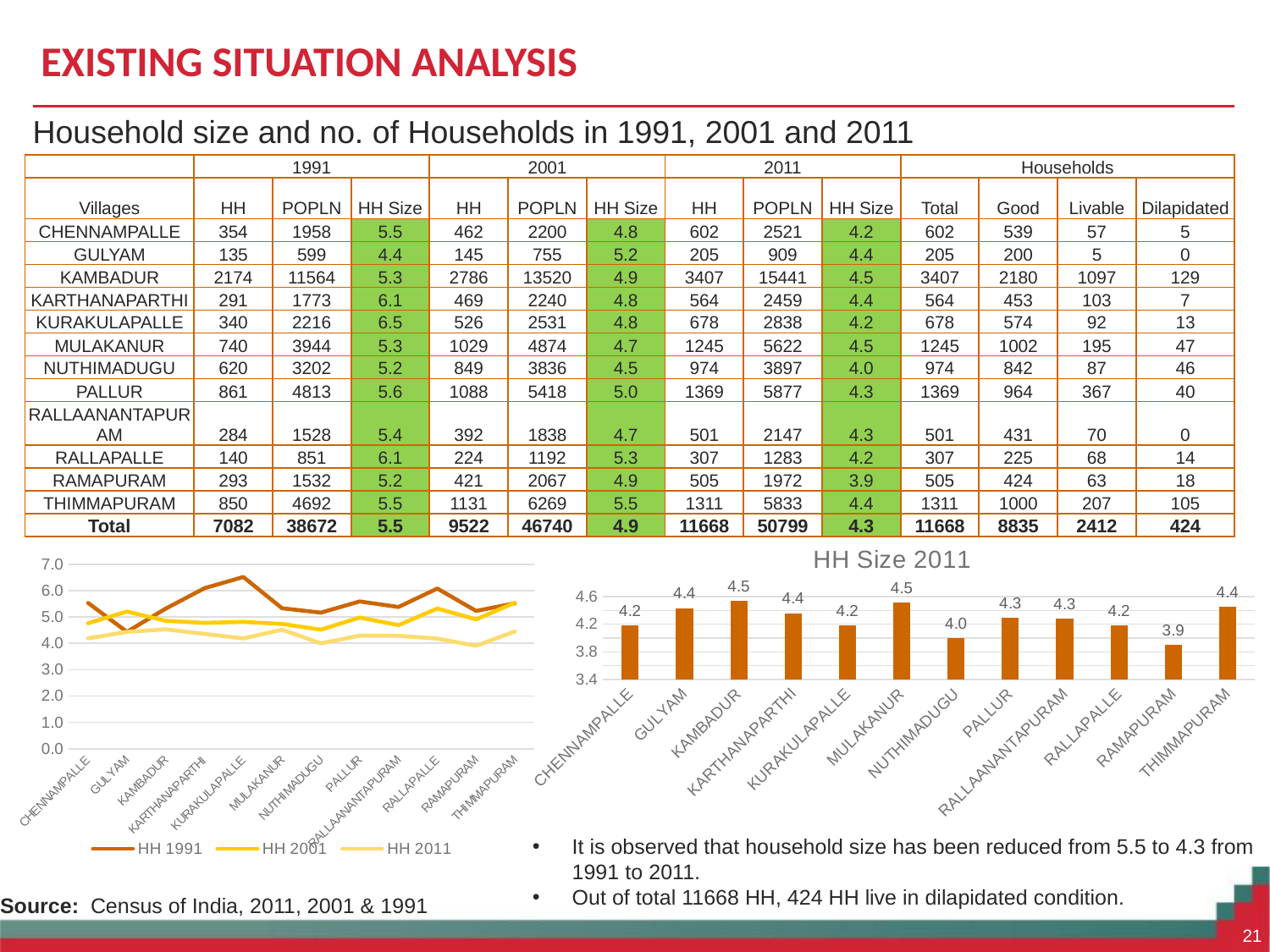
In the line chart on the bottom left, is the HH 1991 value for KURAKULAPALLE greater or less than 6.0? greater In the HH Size 2011 chart, what is the value for THIMMAPURAM? 4.4 In the HH Size 2011 chart, is the value for PALLUR greater or less than 3.8? greater What kind of chart is the chart on the bottom left of the slide? line chart In the HH Size 2011 chart, what is the difference between the values for KAMBADUR and RAMAPURAM? 0.6 How many series does the legend of the line chart on the bottom left list? 3 What kind of chart is the HH Size 2011 chart? bar chart In the HH Size 2011 chart, which village has the lowest household size? RAMAPURAM In the HH Size 2011 chart, which is larger, the value for GULYAM or the value for CHENNAMPALLE? GULYAM In the HH Size 2011 chart, what is the value for NUTHIMADUGU? 4.0 How many villages are shown in the HH Size 2011 chart? 12 In the line chart on the bottom left, is the HH 1991 value for GULYAM greater or less than 5.0? less